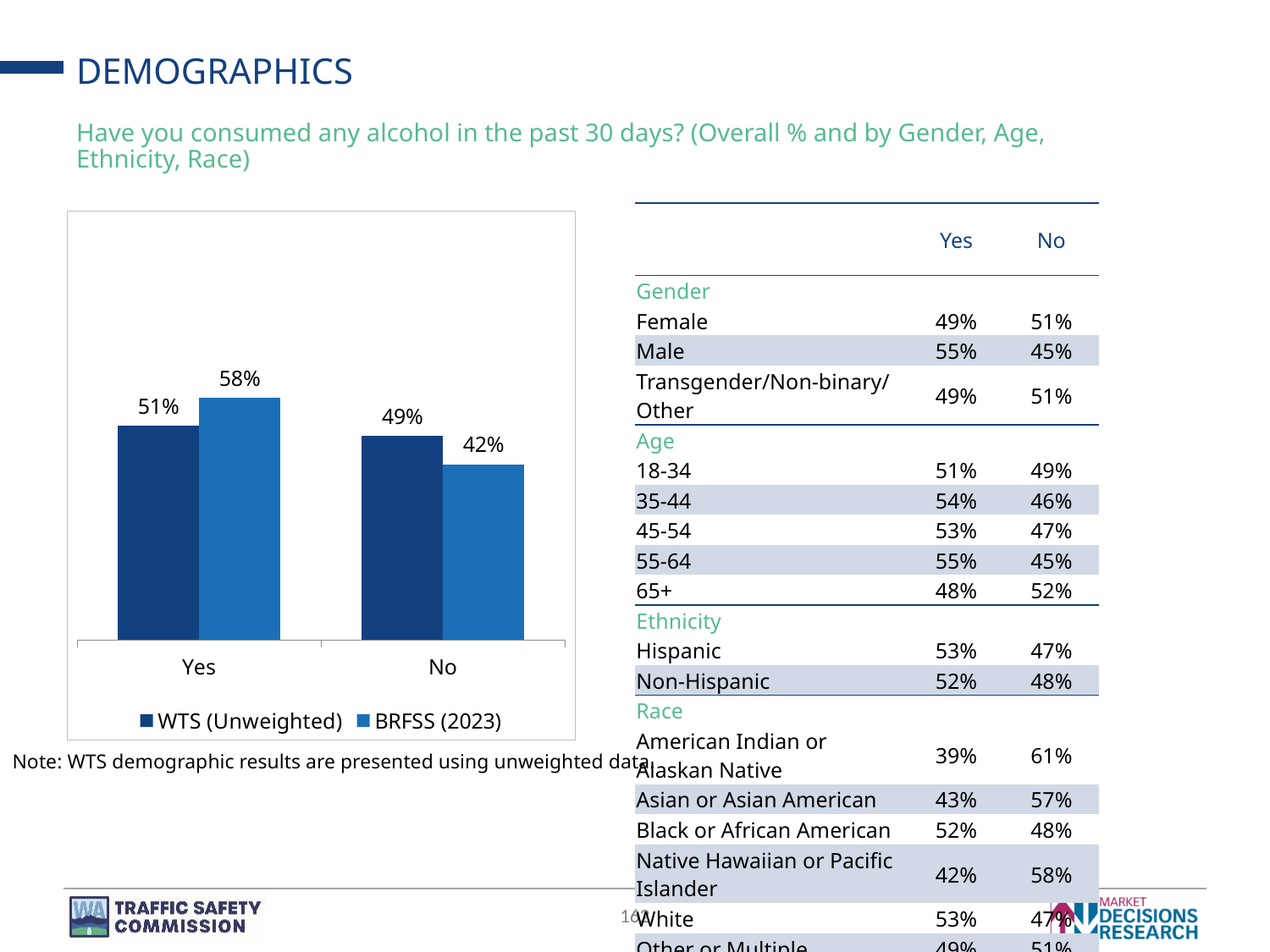
What is the value for WTS (Unweighted) in the Yes category? 51% Which bar in the chart has the highest value? BRFSS (2023), Yes What is the difference between the BRFSS (2023) and WTS (Unweighted) values in the Yes category? 7% What kind of chart is shown on the slide? Bar chart What is the difference between the WTS (Unweighted) and BRFSS (2023) values in the No category? 7% In the No category, which series has the larger value, WTS (Unweighted) or BRFSS (2023)? WTS (Unweighted) How many series does the chart legend list? 2 What is the value for WTS (Unweighted) in the No category? 49% How many categories are shown on the x axis of the chart? 2 What is the value for BRFSS (2023) in the No category? 42% Which bar in the chart has the lowest value? BRFSS (2023), No What is the value for BRFSS (2023) in the Yes category? 58%